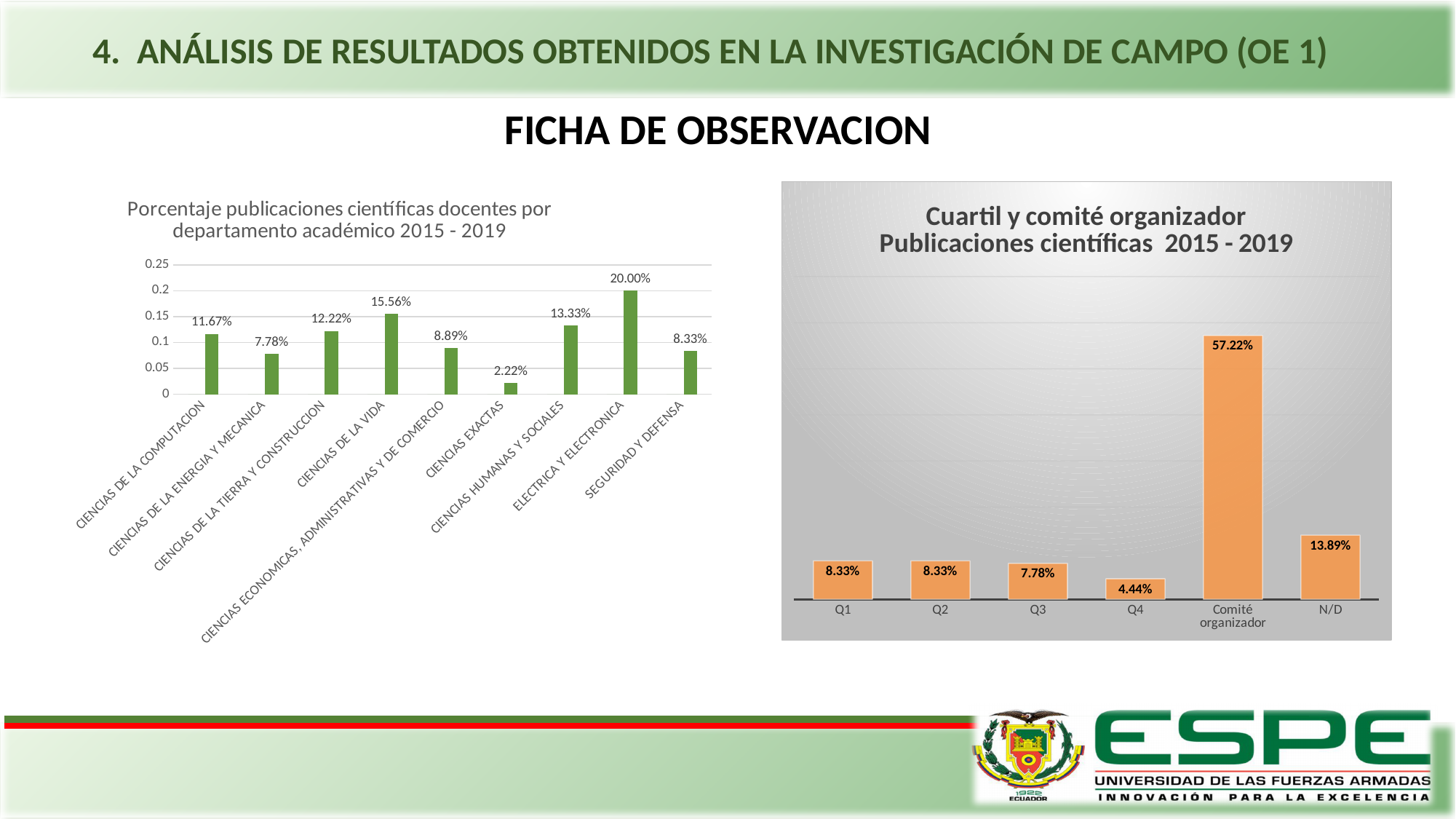
In the left chart 'Porcentaje publicaciones científicas docentes por departamento académico 2015 - 2019', how many departments are shown? 9 What colour are the bars in the left chart 'Porcentaje publicaciones científicas docentes por departamento académico 2015 - 2019'? green In the right chart 'Cuartil y comité organizador Publicaciones científicas 2015 - 2019', how many categories are shown? 6 In the right chart 'Cuartil y comité organizador Publicaciones científicas 2015 - 2019', which category has the lowest value? Q4 In the left chart 'Porcentaje publicaciones científicas docentes por departamento académico 2015 - 2019', which department has the lowest value? CIENCIAS EXACTAS In the right chart 'Cuartil y comité organizador Publicaciones científicas 2015 - 2019', what is the value for Comité organizador? 57.22% In the left chart 'Porcentaje publicaciones científicas docentes por departamento académico 2015 - 2019', what is the difference between ELECTRICA Y ELECTRONICA and CIENCIAS DE LA ENERGIA Y MECANICA? 12.22% In the left chart 'Porcentaje publicaciones científicas docentes por departamento académico 2015 - 2019', what is the value for CIENCIAS DE LA VIDA? 15.56% What type of chart is the right chart 'Cuartil y comité organizador Publicaciones científicas 2015 - 2019'? bar chart In the left chart 'Porcentaje publicaciones científicas docentes por departamento académico 2015 - 2019', which is larger: CIENCIAS HUMANAS Y SOCIALES or SEGURIDAD Y DEFENSA? CIENCIAS HUMANAS Y SOCIALES In the right chart 'Cuartil y comité organizador Publicaciones científicas 2015 - 2019', what is the difference between N/D and Q3? 6.11% In the left chart 'Porcentaje publicaciones científicas docentes por departamento académico 2015 - 2019', which department has the highest value? ELECTRICA Y ELECTRONICA